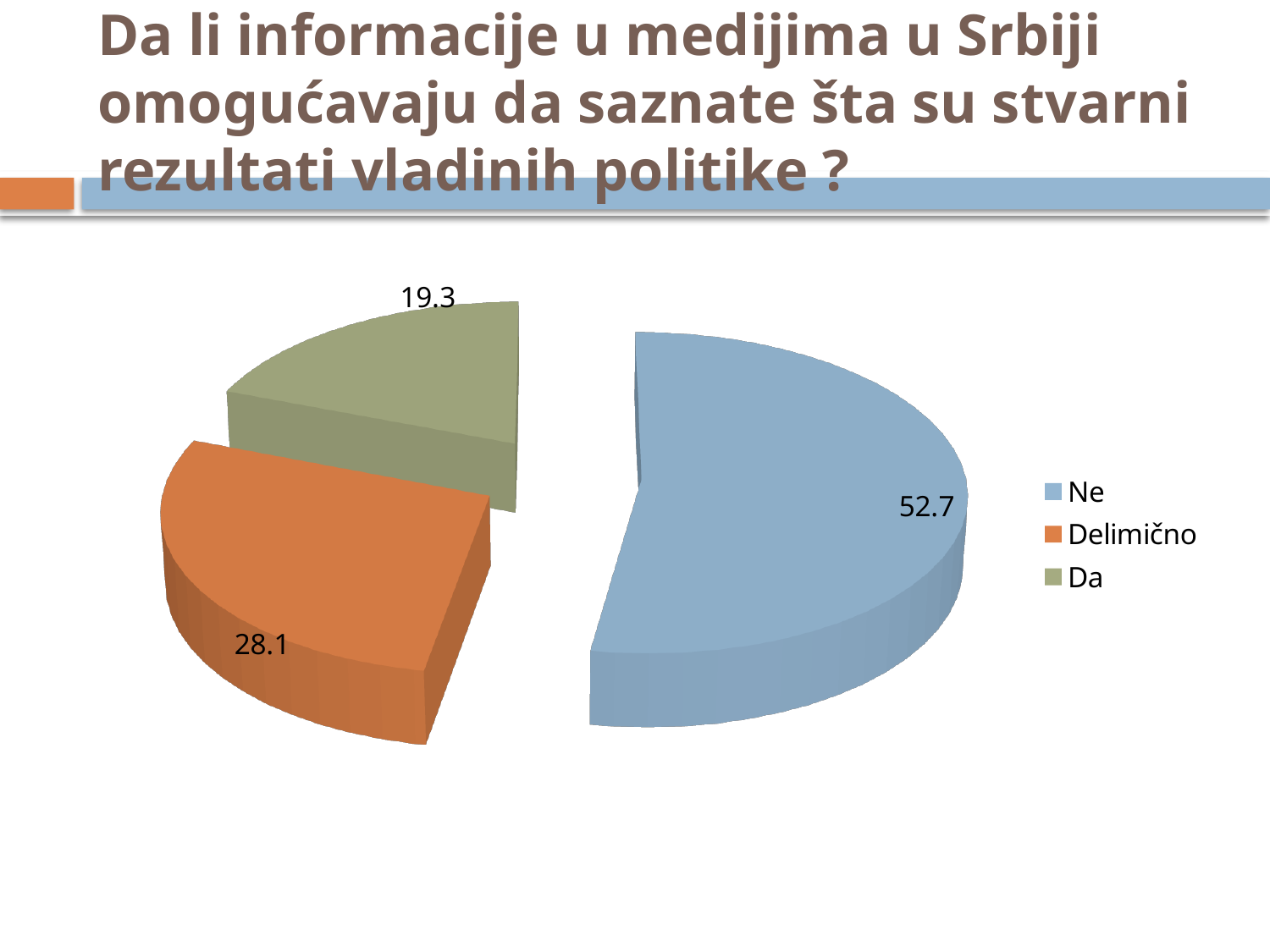
What kind of chart is shown on the slide? pie chart What is the value for Ne? 52.7 How many categories does the pie chart have? 3 What is the difference between the values for Delimično and Da? 8.8 What colour is the slice for Ne? blue Which is larger, the value for Delimično or the value for Da? Delimično Which category has the largest slice? Ne What is the difference between the values for Ne and Delimično? 24.6 What is the value for Delimično? 28.1 Which category has the smallest slice? Da What is the value for Da? 19.3 How many entries does the legend list? 3